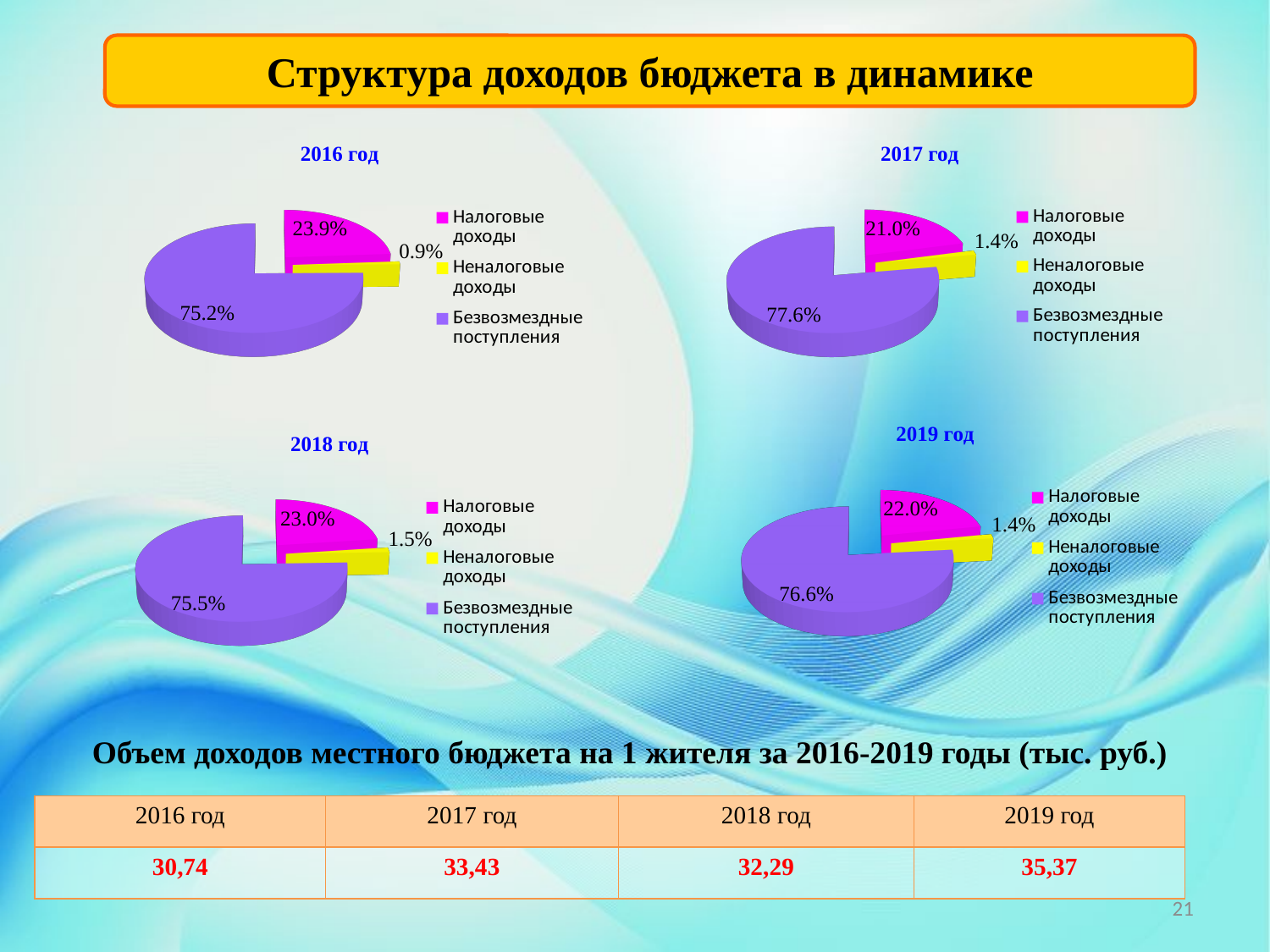
What colour represents Неналоговые доходы in the 2017 год chart? Yellow In the 2016 год chart, what share is shown for Налоговые доходы? 23.9% In the 2018 год chart, what share is shown for Неналоговые доходы? 1.5% How many entries does the legend of the 2019 год chart list? 3 Is the share of Налоговые доходы larger in the 2016 год chart or in the 2017 год chart? 2016 год In the 2017 год chart, what is the difference between the shares of Безвозмездные поступления and Налоговые доходы? 56.6% What type of chart is used for 2016 год? Pie chart In the 2019 год chart, what share is shown for Налоговые доходы? 22.0% In the 2019 год chart, which category has the smallest slice? Неналоговые доходы In the 2017 год chart, what share is shown for Безвозмездные поступления? 77.6% How many slices does the 2018 год pie chart have? 3 In the 2016 год chart, which category has the largest slice? Безвозмездные поступления